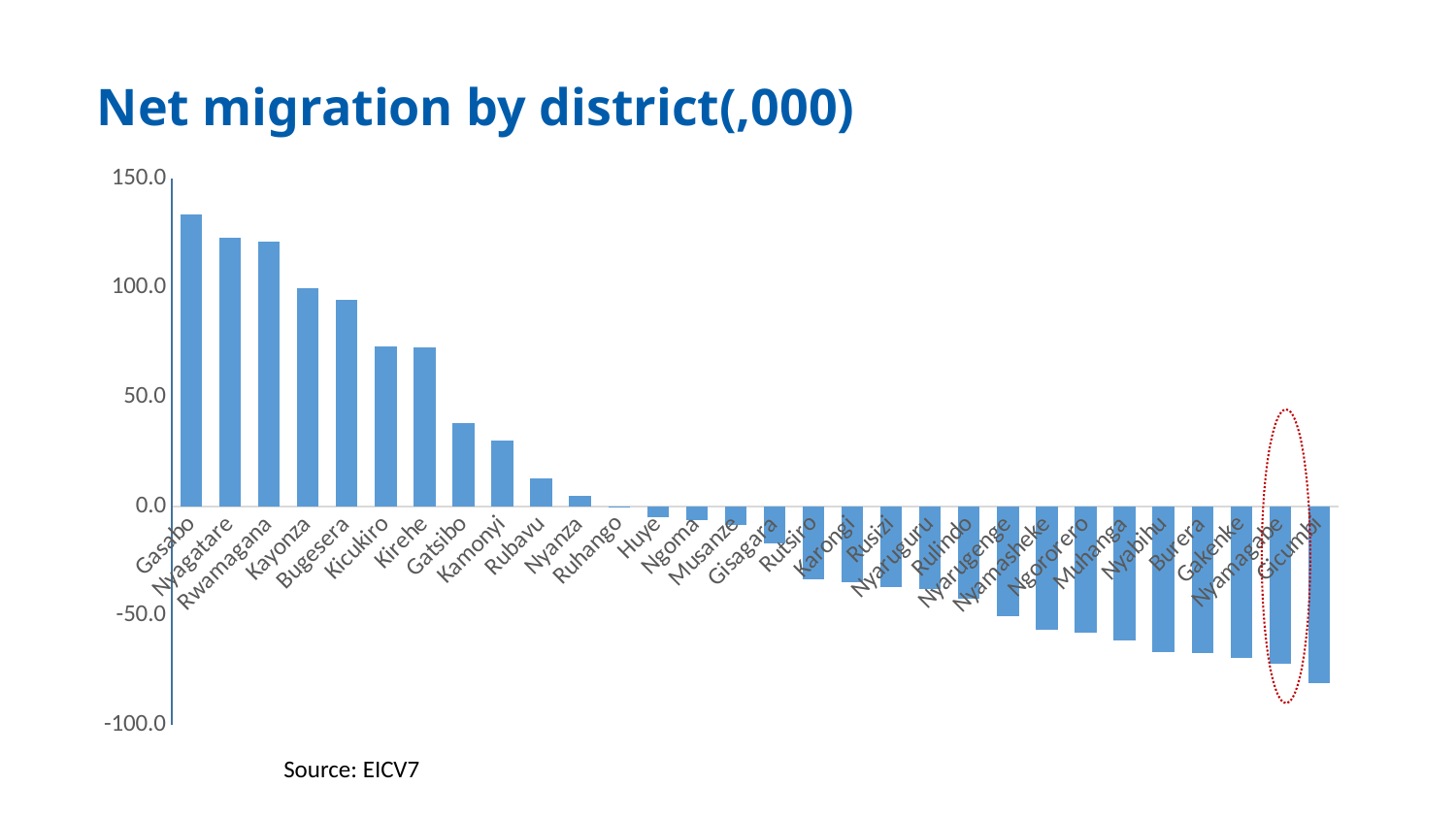
Which district has the highest net migration? Gasabo Do the values rise or fall moving from left to right along the x axis? fall Is the value for Gatsibo greater or less than 50.0? less Is the value for Gicumbi greater or less than -50.0? less Which district has a higher net migration, Gasabo or Nyagatare? Gasabo What kind of chart is shown on the slide? bar chart Which district's bar is circled with a dotted red outline? Nyamagabe Which district has the lowest net migration? Gicumbi Is the value for Kicukiro greater or less than 50.0? greater How many districts are plotted in the chart? 30